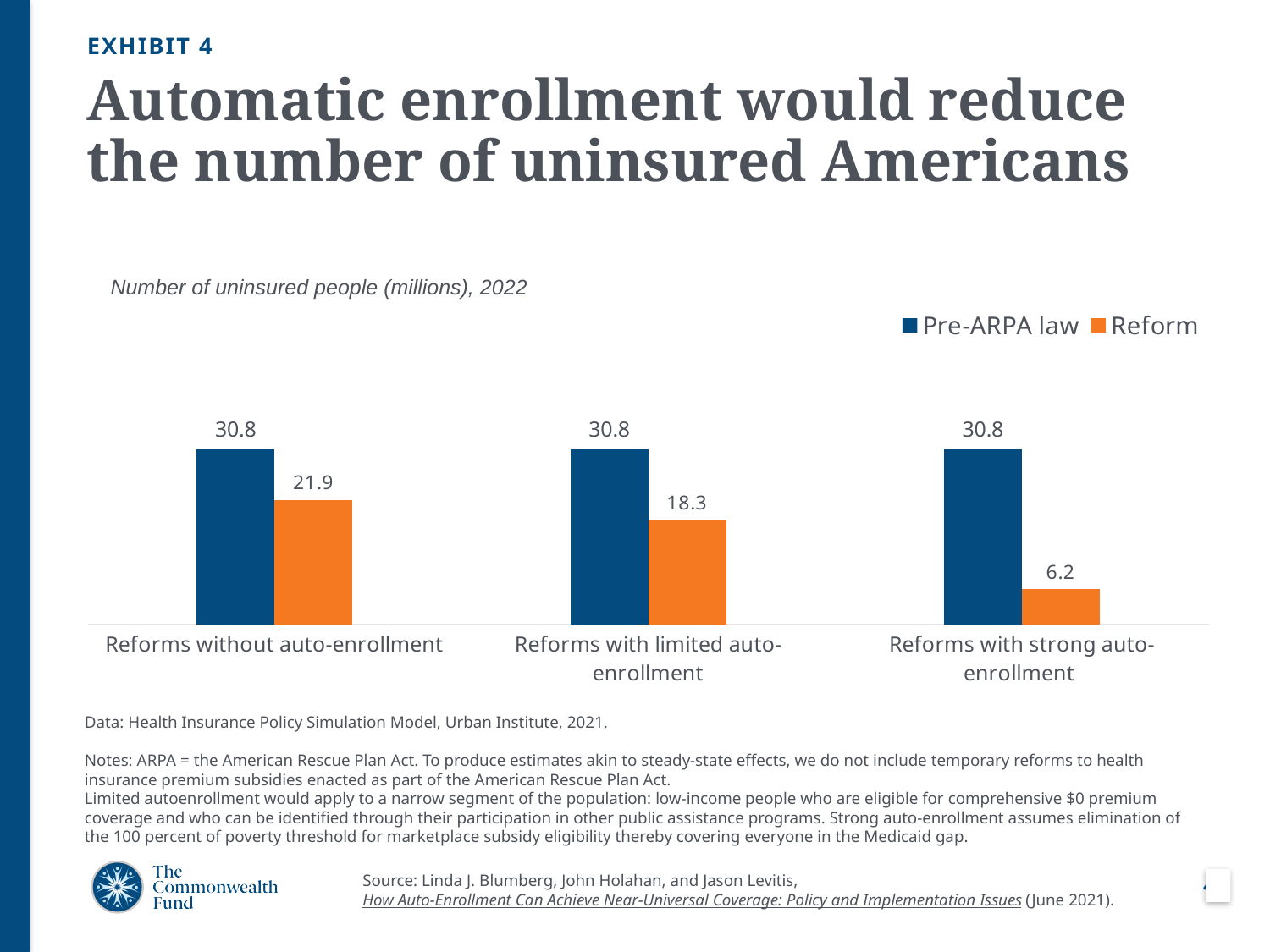
What is the difference between the Reform values for Reforms without auto-enrollment and Reforms with limited auto-enrollment? 3.6 What is the Pre-ARPA law value for Reforms with limited auto-enrollment? 30.8 What kind of chart is shown on the slide? Bar chart How many series does the legend list? 2 What is the Reform value for Reforms with limited auto-enrollment? 18.3 What is the difference between the Pre-ARPA law and Reform values for Reforms with strong auto-enrollment? 24.6 Which category has the lowest Reform value? Reforms with strong auto-enrollment How many categories are shown on the x axis? 3 Which is larger: the Reform value for Reforms with limited auto-enrollment or the Reform value for Reforms with strong auto-enrollment? Reforms with limited auto-enrollment What is the Reform value for Reforms without auto-enrollment? 21.9 What is the Reform value for Reforms with strong auto-enrollment? 6.2 Which category has the highest Reform value? Reforms without auto-enrollment